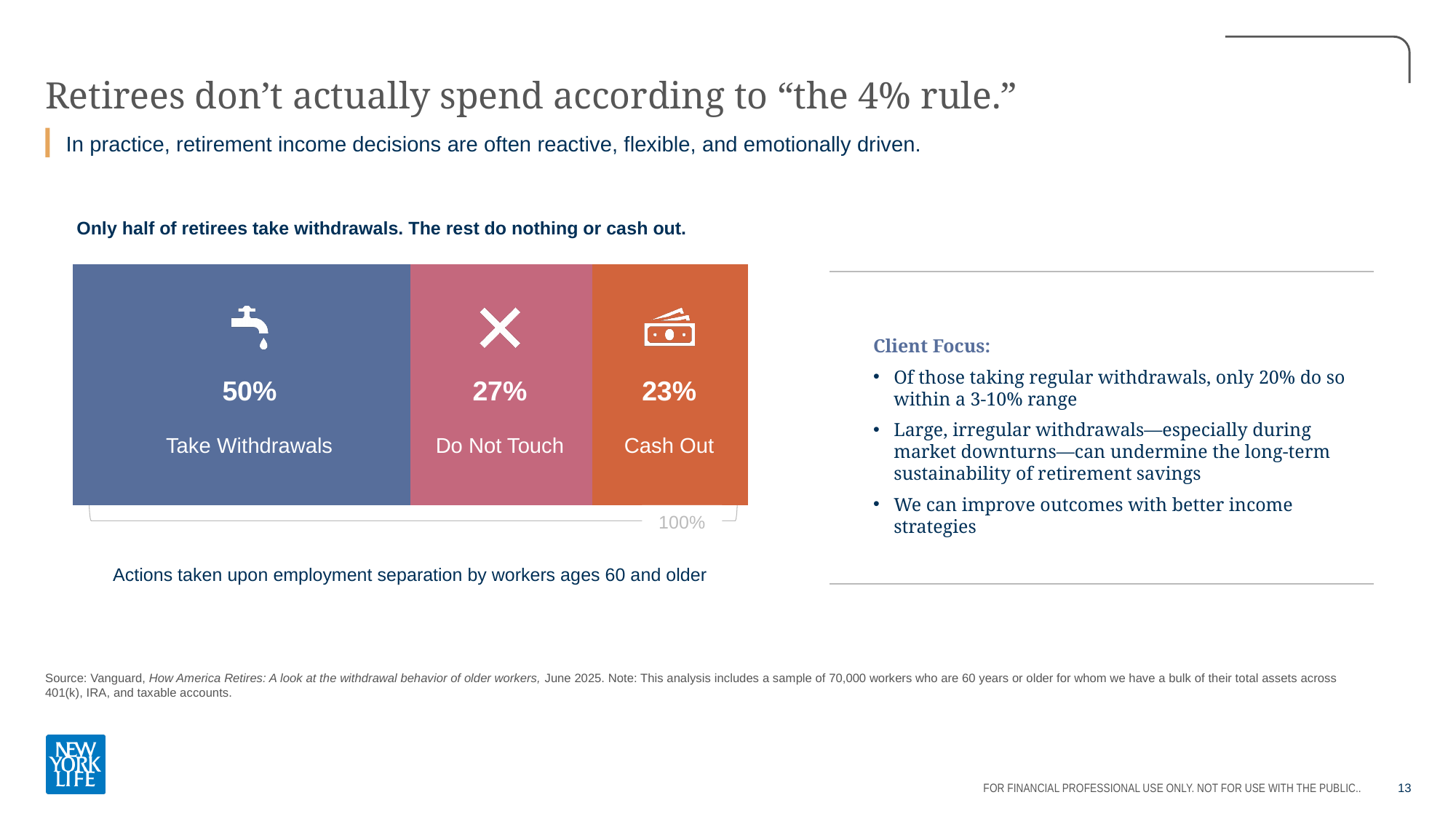
What is the caption below the chart? Actions taken upon employment separation by workers ages 60 and older What percentage of workers ages 60 and older do not touch their savings upon employment separation? 27% What is the difference in percentage points between Do Not Touch and Cash Out? 4 Which action has the smallest share in the chart? Cash Out How many action categories are shown in the chart? 3 What kind of chart is shown on the slide? Stacked bar chart Which action has the largest share in the chart? Take Withdrawals What percentage of workers ages 60 and older cash out upon employment separation? 23% Which is larger, the share for Do Not Touch or the share for Cash Out? Do Not Touch What percentage of workers ages 60 and older take withdrawals upon employment separation? 50% What do the three segments of the chart add up to? 100% What is the difference in percentage points between Take Withdrawals and Do Not Touch? 23